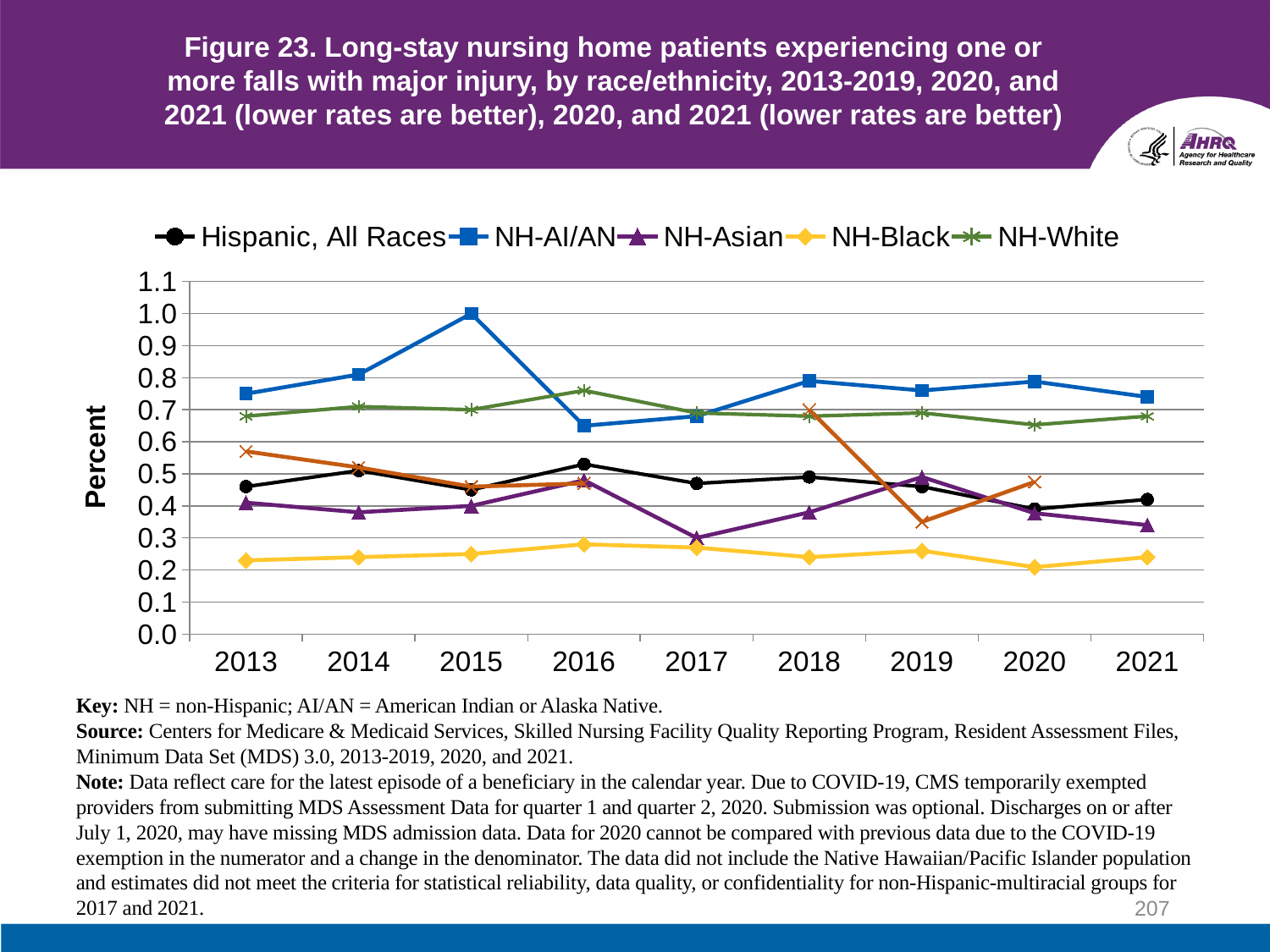
What type of chart is shown on the slide? line chart How many years are shown on the x axis? 9 What is the label on the y axis? Percent Which race/ethnicity group has the lowest values across all years shown? NH-Black Does the NH-AI/AN series rise or fall from 2013 to 2015? rise What is the value for NH-AI/AN in 2015? 1.0 Which race/ethnicity group has the highest value in 2015? NH-AI/AN Is the value for NH-AI/AN in 2016 greater or less than 0.8? less In which year does the NH-AI/AN series reach its highest value? 2015 In 2013, which is larger: the value for NH-AI/AN or the value for NH-White? NH-AI/AN Is the value for NH-Black in 2016 greater or less than 0.4? less How many series does the legend list? 5